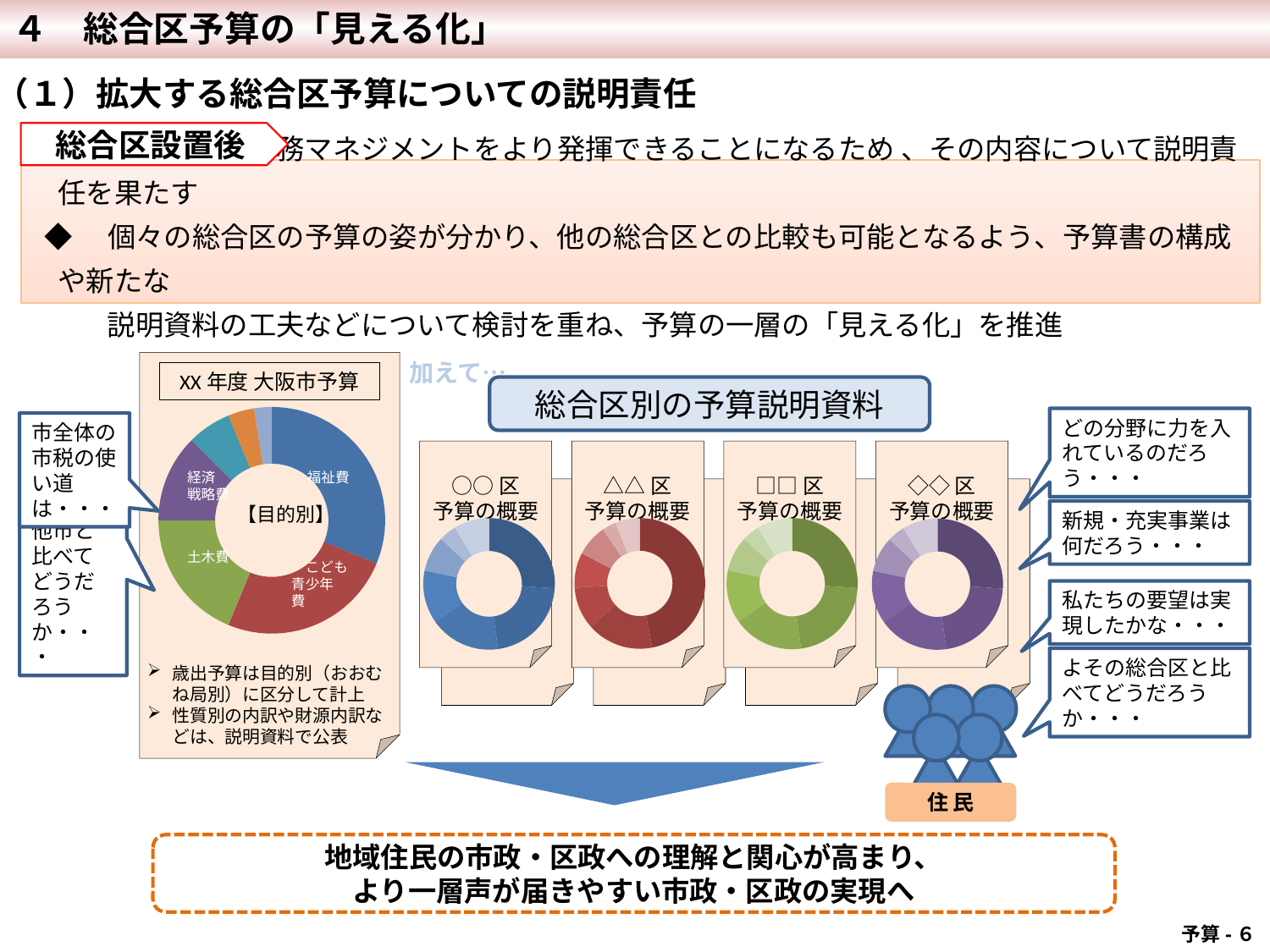
What kind of chart is the 'XX 年度 大阪市予算' chart on the left of the slide? Donut (pie) chart How many small district donut charts are shown under the heading '総合区別の予算説明資料'? 4 In the 'XX 年度 大阪市予算' chart, which slice is larger, 土木費 or こども青少年費? こども青少年費 What text is shown in the centre of the 'XX 年度 大阪市予算' donut chart? 【目的別】 What colour is the 福祉費 slice in the 'XX 年度 大阪市予算' chart? Blue In the 'XX 年度 大阪市予算' chart, which labeled category has the largest slice? 福祉費 In the 'XX 年度 大阪市予算' chart, which slice is larger, 福祉費 or 土木費? 福祉費 In the 'XX 年度 大阪市予算' chart, which slice is larger, こども青少年費 or 経済戦略費? こども青少年費 In the 'XX 年度 大阪市予算' chart, which labeled category has the smallest slice? 経済戦略費 How many slices in the 'XX 年度 大阪市予算' chart have a category label printed on them? 4